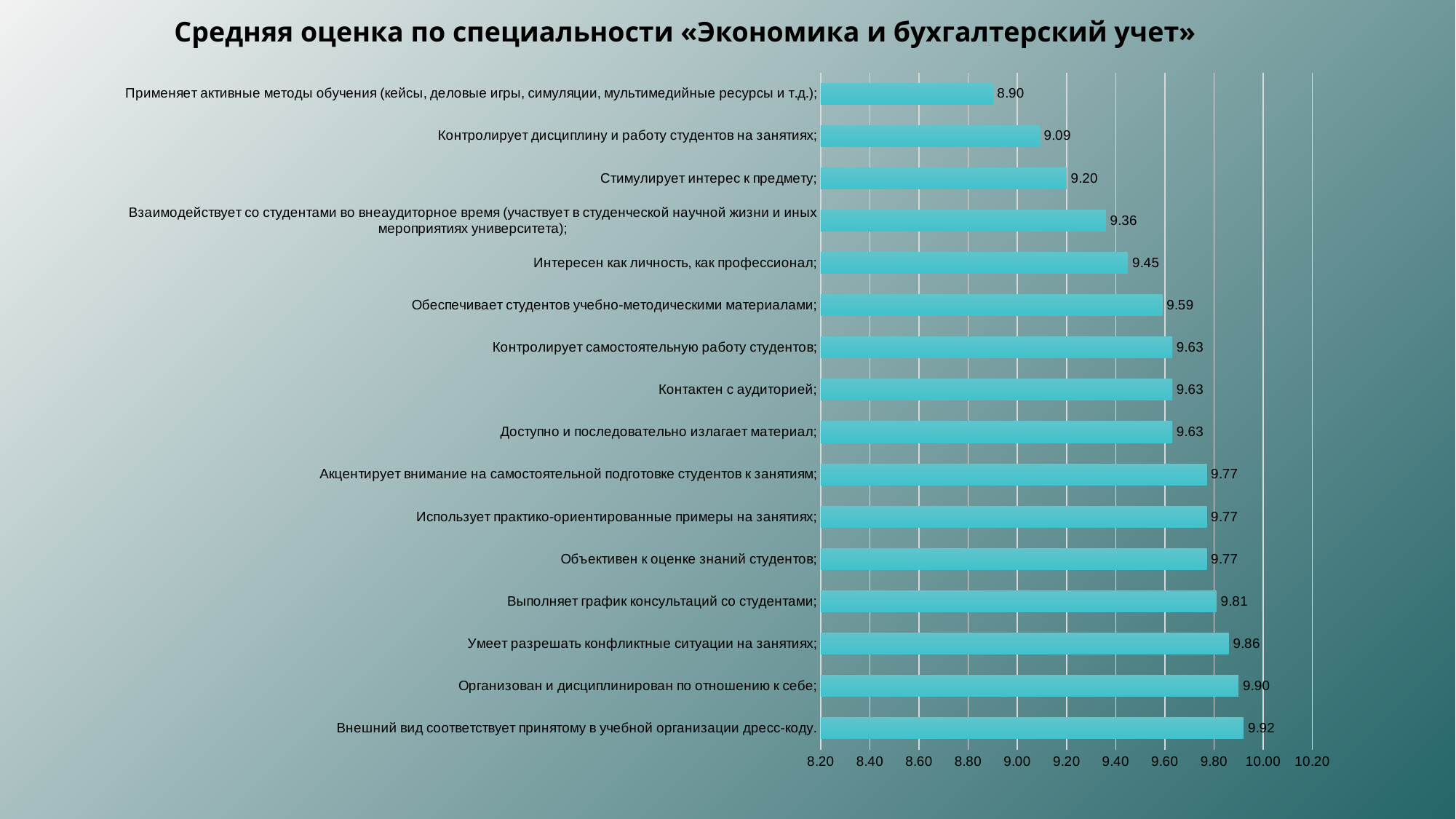
Which category has the lowest average score? Применяет активные методы обучения (кейсы, деловые игры, симуляции, мультимедийные ресурсы и т.д.) What value is shown for «Выполняет график консультаций со студентами»? 9.81 Which category has the highest average score? Внешний вид соответствует принятому в учебной организации дресс-коду By how much does «Умеет разрешать конфликтные ситуации на занятиях» exceed «Интересен как личность, как профессионал»? 0.41 What type of chart is shown on the slide? Bar chart Is the value for «Организован и дисциплинирован по отношению к себе» greater or less than 9.80? greater What is the average score for «Стимулирует интерес к предмету»? 9.20 What is the title of the chart? Средняя оценка по специальности «Экономика и бухгалтерский учет» How many categories are shown in the chart? 16 Which is larger: the value for «Обеспечивает студентов учебно-методическими материалами» or for «Взаимодействует со студентами во внеаудиторное время»? Обеспечивает студентов учебно-методическими материалами What is the difference between the highest value (9.92) and the lowest value (8.90)? 1.02 What is the value for «Контролирует дисциплину и работу студентов на занятиях»? 9.09